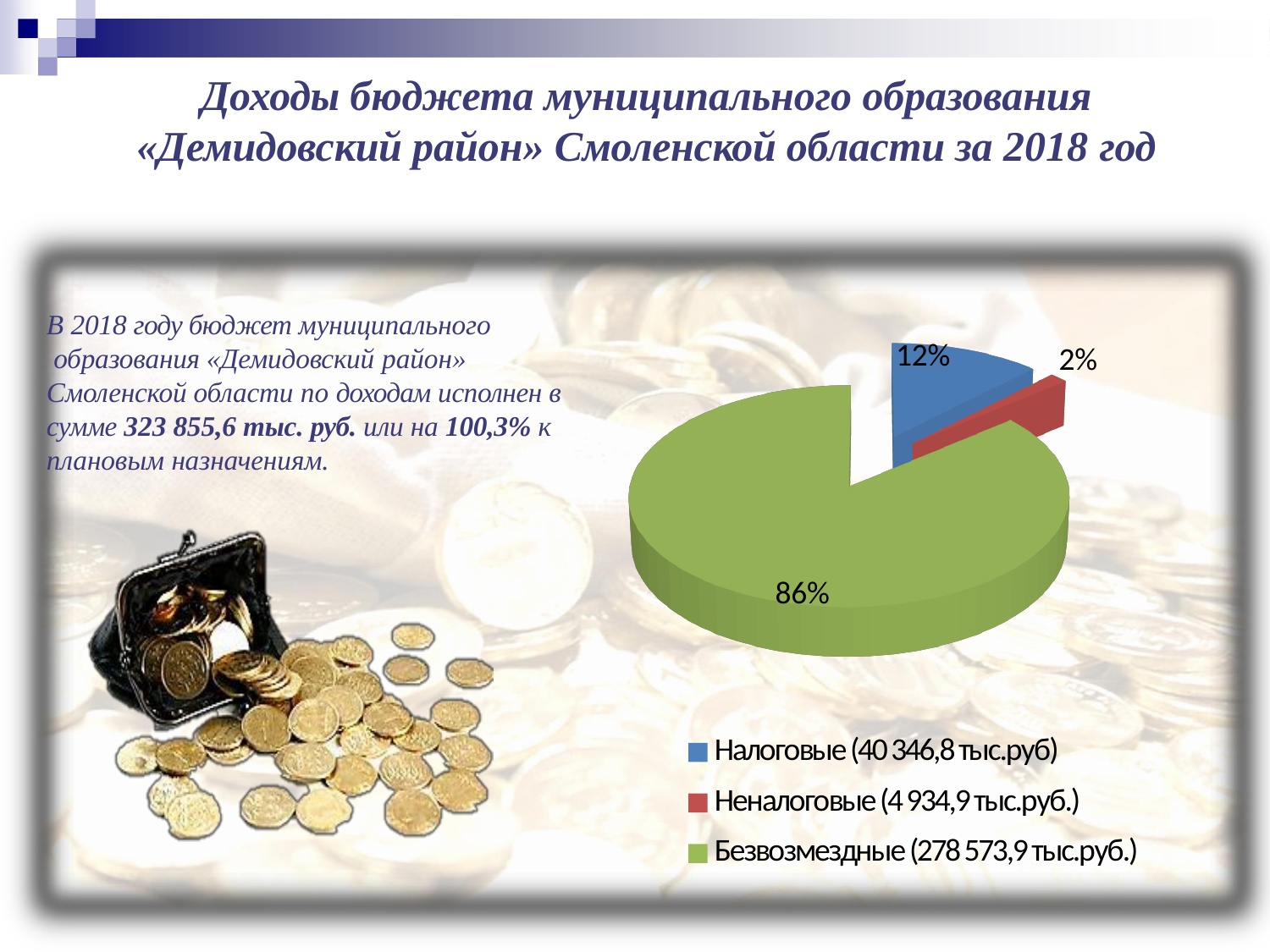
What is the difference in percentage points between the Безвозмездные and Налоговые slices? 74 What amount in тыс.руб. does the legend give for Налоговые? 40 346,8 тыс.руб What amount in тыс.руб. does the legend give for Безвозмездные? 278 573,9 тыс.руб. Which category has the smallest slice of the pie? Неналоговые What colour is the Неналоговые slice in the pie chart? red What kind of chart is shown on the slide? pie chart How many slices does the pie chart have? 3 What share of the pie does the Неналоговые slice represent? 2% Which slice is larger, Налоговые or Неналоговые? Налоговые What share of the pie does the Безвозмездные slice represent? 86% Which category has the largest slice of the pie? Безвозмездные What share of the pie does the Налоговые slice represent? 12%